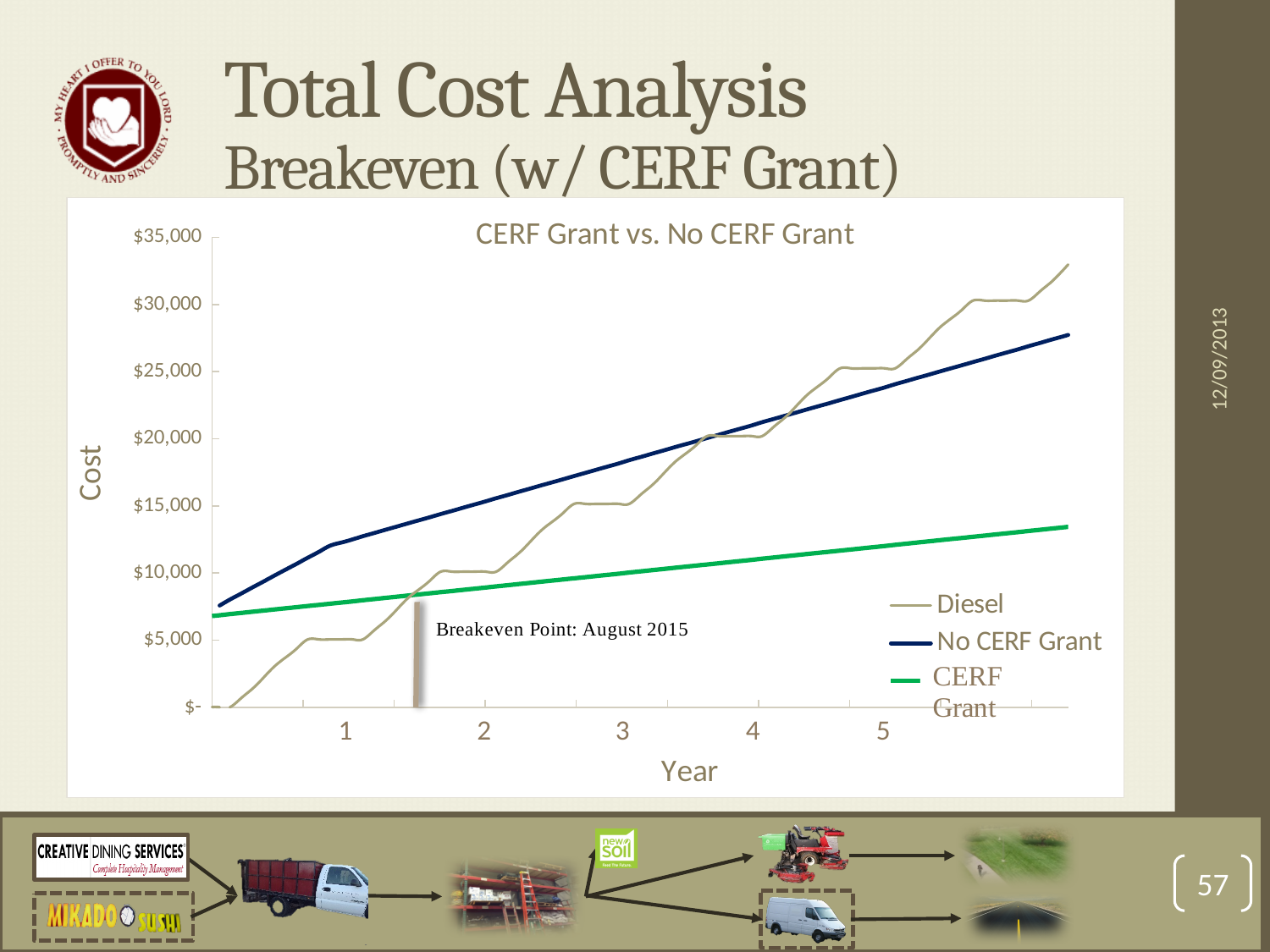
At year 1, which is larger: No CERF Grant or Diesel? No CERF Grant Is the value for Diesel at the right end of the chart greater or less than $30,000? greater At year 5, which is larger: Diesel or CERF Grant? Diesel What breakeven point is annotated on the chart? August 2015 Is the value for CERF Grant at year 2 greater or less than $10,000? less How many series does the chart legend list? 3 Is the value for No CERF Grant at year 1 greater or less than $10,000? greater What is the title of the chart? CERF Grant vs. No CERF Grant Does the Diesel series rise or fall as the year increases? Rise What kind of chart is shown on the slide? Line chart Does the CERF Grant series rise or fall along the x axis? Rise